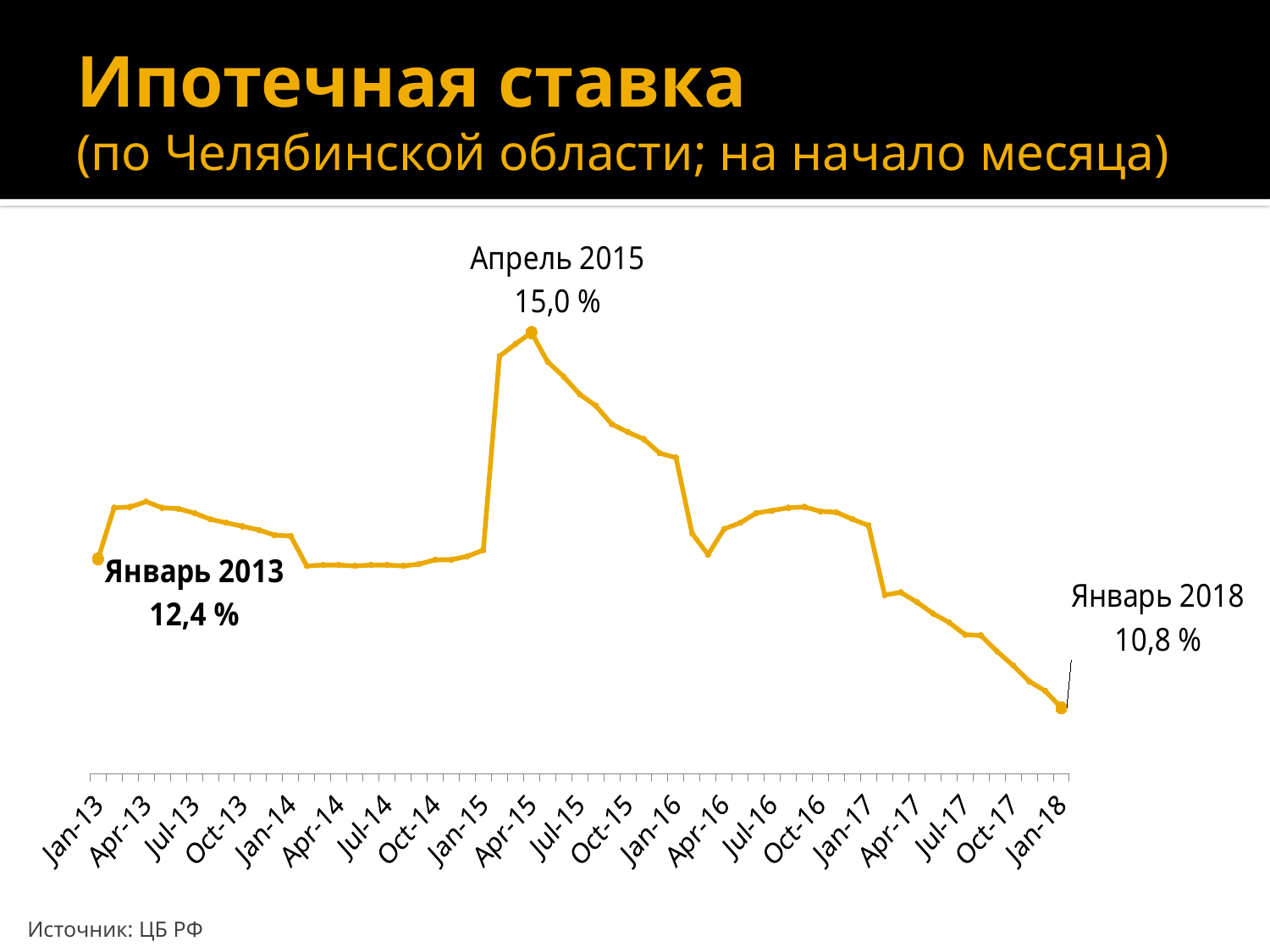
What is the mortgage rate shown for April 2015 (Апрель 2015)? 15,0 % Does the mortgage rate rise or fall between April 2015 and January 2018? Fall What is the title of the chart on the slide? Ипотечная ставка (по Челябинской области; на начало месяца) What is the difference between the rate in January 2013 and the rate in January 2018? 1,6 % At which labelled point is the mortgage rate at its lowest value? Январь 2018 What source is cited for the chart data? ЦБ РФ By how much is the rate in April 2015 higher than the rate in January 2013? 2,6 % At which labelled point does the mortgage rate reach its highest value? Апрель 2015 What kind of chart is shown on the slide? Line chart Which is higher: the rate in January 2013 or the rate in January 2018? January 2013 What is the mortgage rate shown for January 2013 (Январь 2013)? 12,4 % What is the mortgage rate shown for January 2018 (Январь 2018)? 10,8 %